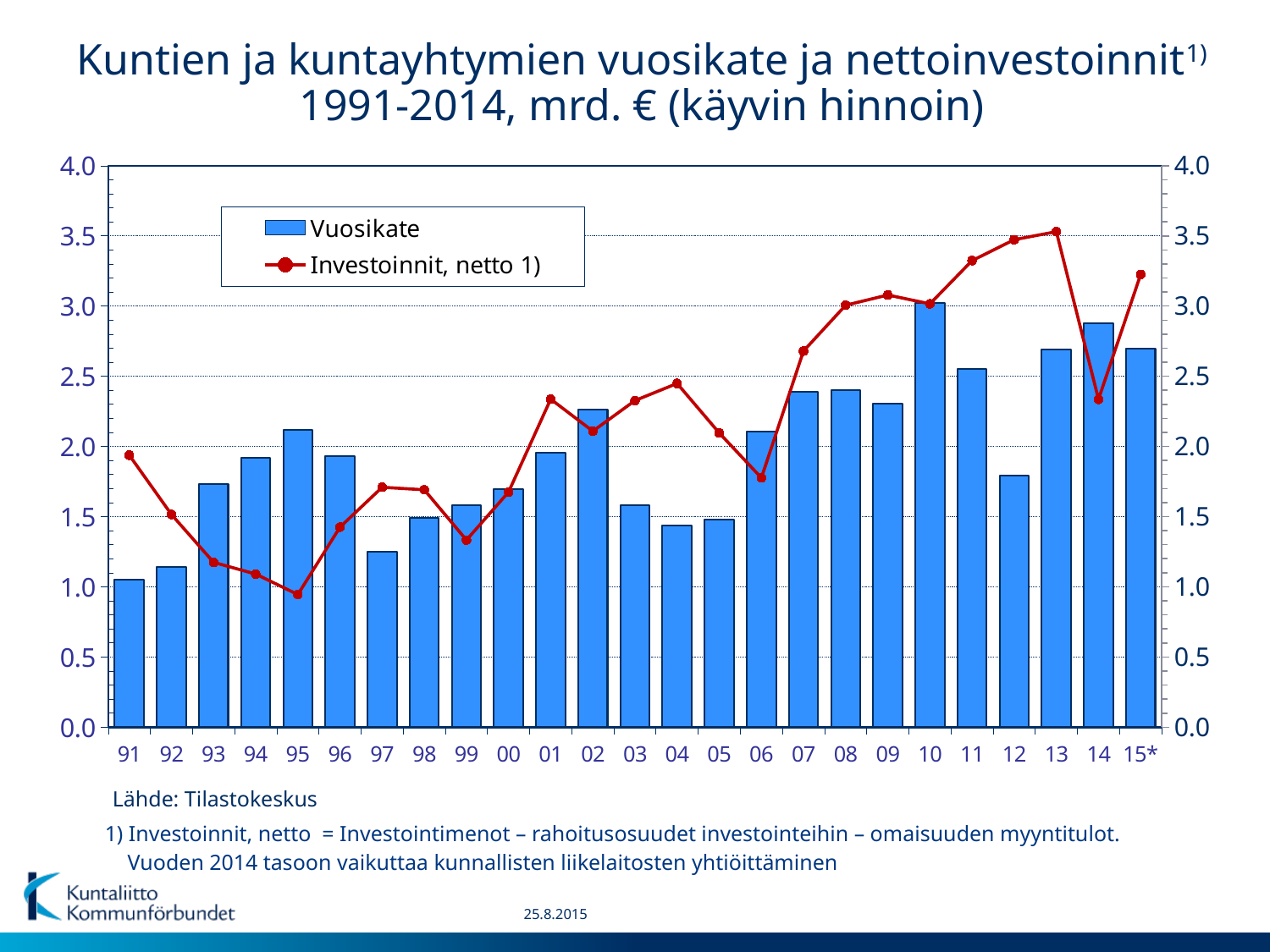
Is the Investoinnit, netto value for 06 greater or less than 2.0? less Which is larger, the Vuosikate value for 10 or for 11? 10 Does the Investoinnit, netto line rise or fall from 91 to 95? fall How many years are shown on the x axis? 25 How many series does the legend list? 2 In which year is the Vuosikate bar lowest? 91 Is the Vuosikate value for 97 greater or less than 1.5? less In which year is the Vuosikate bar highest? 10 Which source is cited below the chart? Tilastokeskus What kind of chart is this? Combined bar and line chart In which year does the Investoinnit, netto line reach its highest point? 13 In which year does the Investoinnit, netto line reach its lowest point? 95